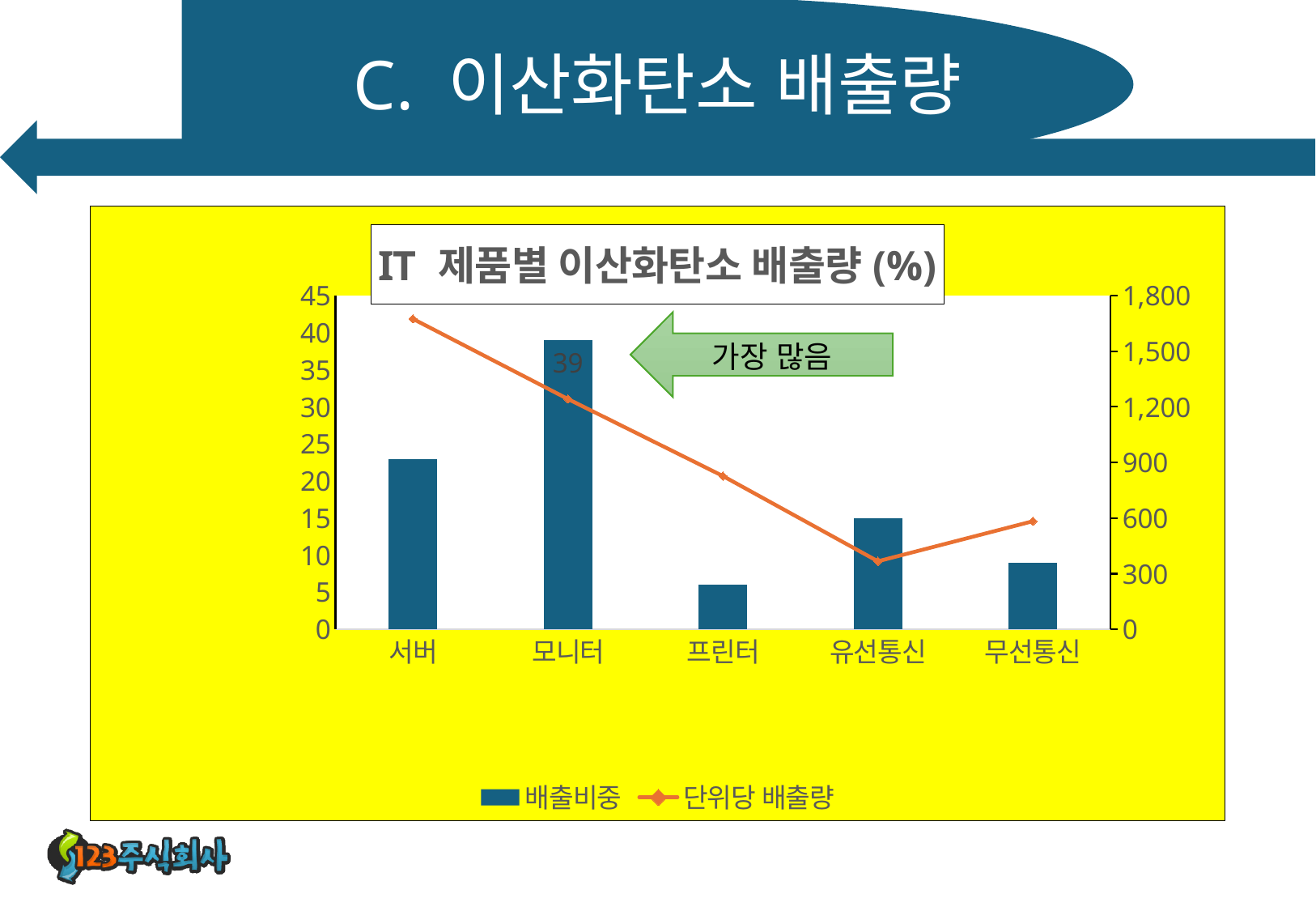
Which category has the lowest 배출비중 bar? 프린터 How many categories are shown on the x axis? 5 Which category has the lowest value on the 단위당 배출량 line? 유선통신 How many series does the legend list? 2 Which has the larger 배출비중 bar, 서버 or 유선통신? 서버 What is the value of the 배출비중 bar for 모니터? 39 Is the 배출비중 bar for 프린터 greater or less than 10? less Is the 배출비중 bar for 서버 greater or less than 20? greater Which category has the highest value on the 단위당 배출량 line? 서버 Is the 단위당 배출량 value for 서버 greater or less than 1,500? greater Which category has the highest 배출비중 bar? 모니터